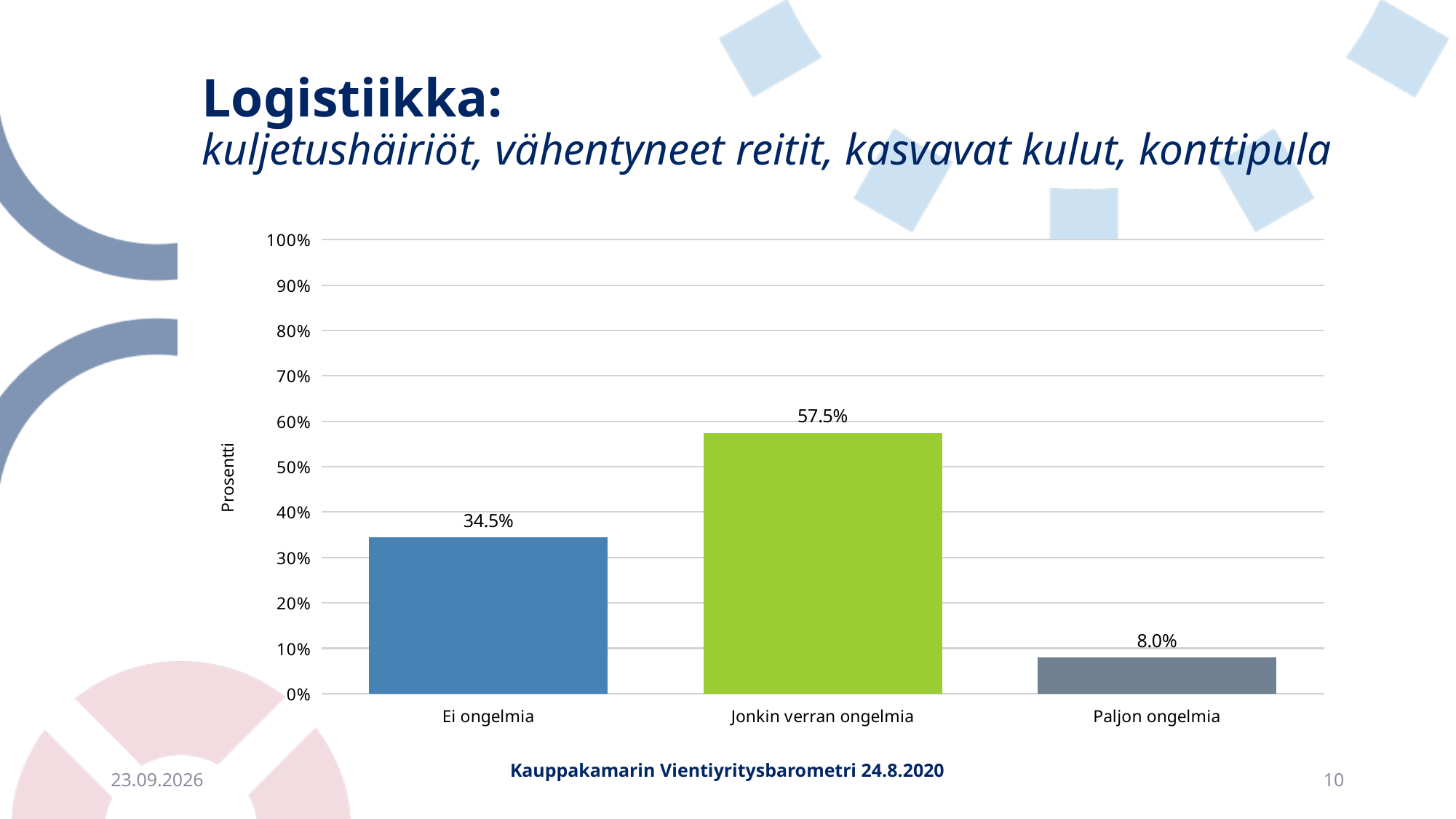
What is the value for "Paljon ongelmia"? 8.0% What is the value for "Ei ongelmia"? 34.5% What is the value for "Jonkin verran ongelmia"? 57.5% Which category has the lowest value? Paljon ongelmia Is the value for "Jonkin verran ongelmia" greater or less than 50%? greater Which is larger, the value for "Ei ongelmia" or the value for "Paljon ongelmia"? Ei ongelmia What is the label of the vertical axis? Prosentti Which category has the highest value? Jonkin verran ongelmia What is the difference between the values for "Jonkin verran ongelmia" and "Ei ongelmia"? 23.0% How many categories are shown on the x axis? 3 What kind of chart is shown on the slide? bar chart What is the difference between the values for "Ei ongelmia" and "Paljon ongelmia"? 26.5%